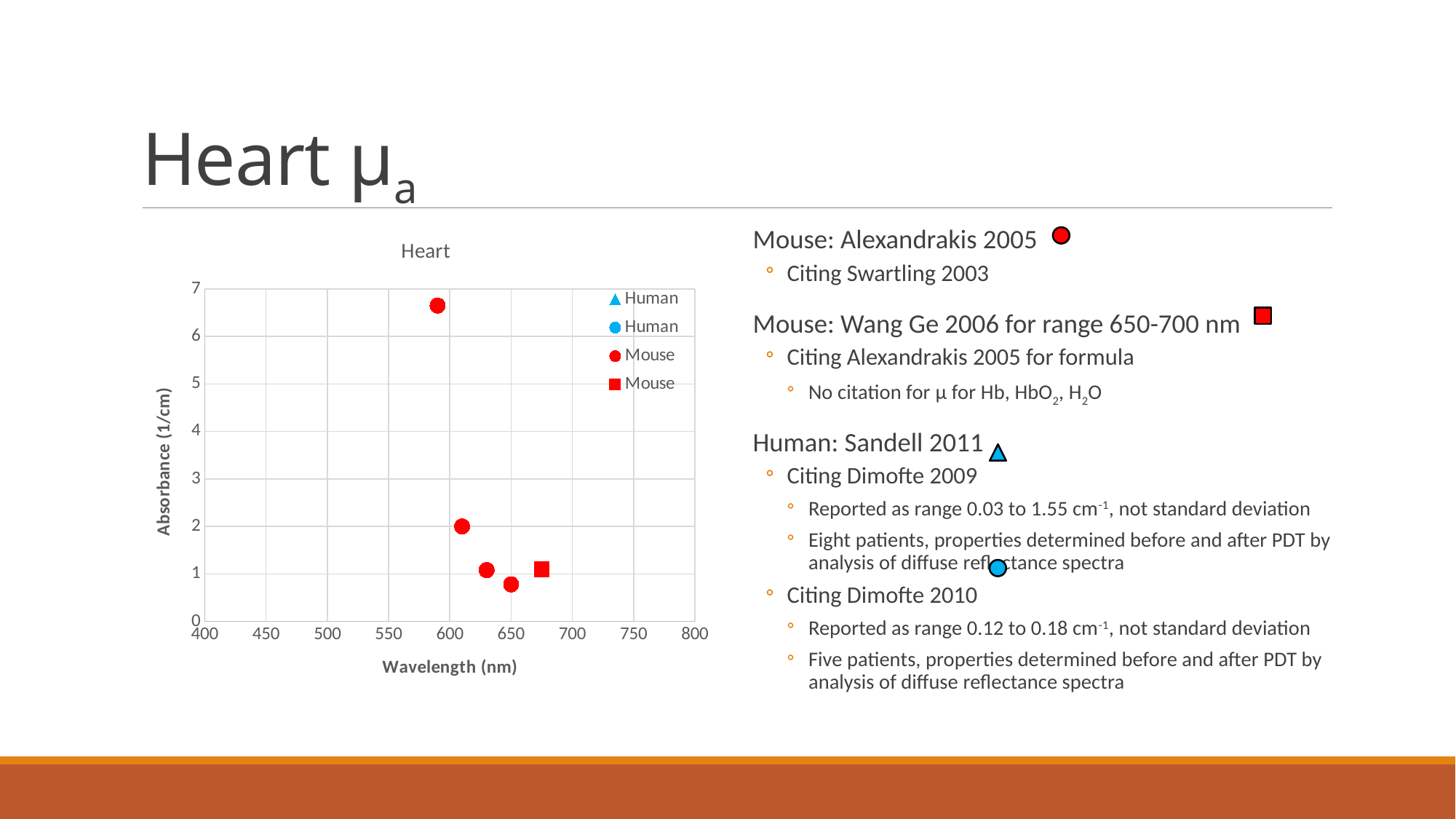
What is the title of the chart? Heart Do the red circle (Mouse) absorbance values rise or fall as wavelength increases? fall Which plotted point has the lowest absorbance? the red circle near 650 nm Is the absorbance of the red circle point near 650 nm greater or less than 1? less Is the absorbance of the red circle point near 610 nm greater or less than 3? less What kind of chart is shown on the slide? scatter chart Is the absorbance of the red circle point near 590 nm greater or less than 6? greater How many series does the chart legend list? 4 How many red circle (Mouse) points are plotted on the chart? 4 What is the label of the chart's y axis? Absorbance (1/cm) How many data points are plotted on the chart? 5 Which plotted point has the highest absorbance? the red circle near 590 nm